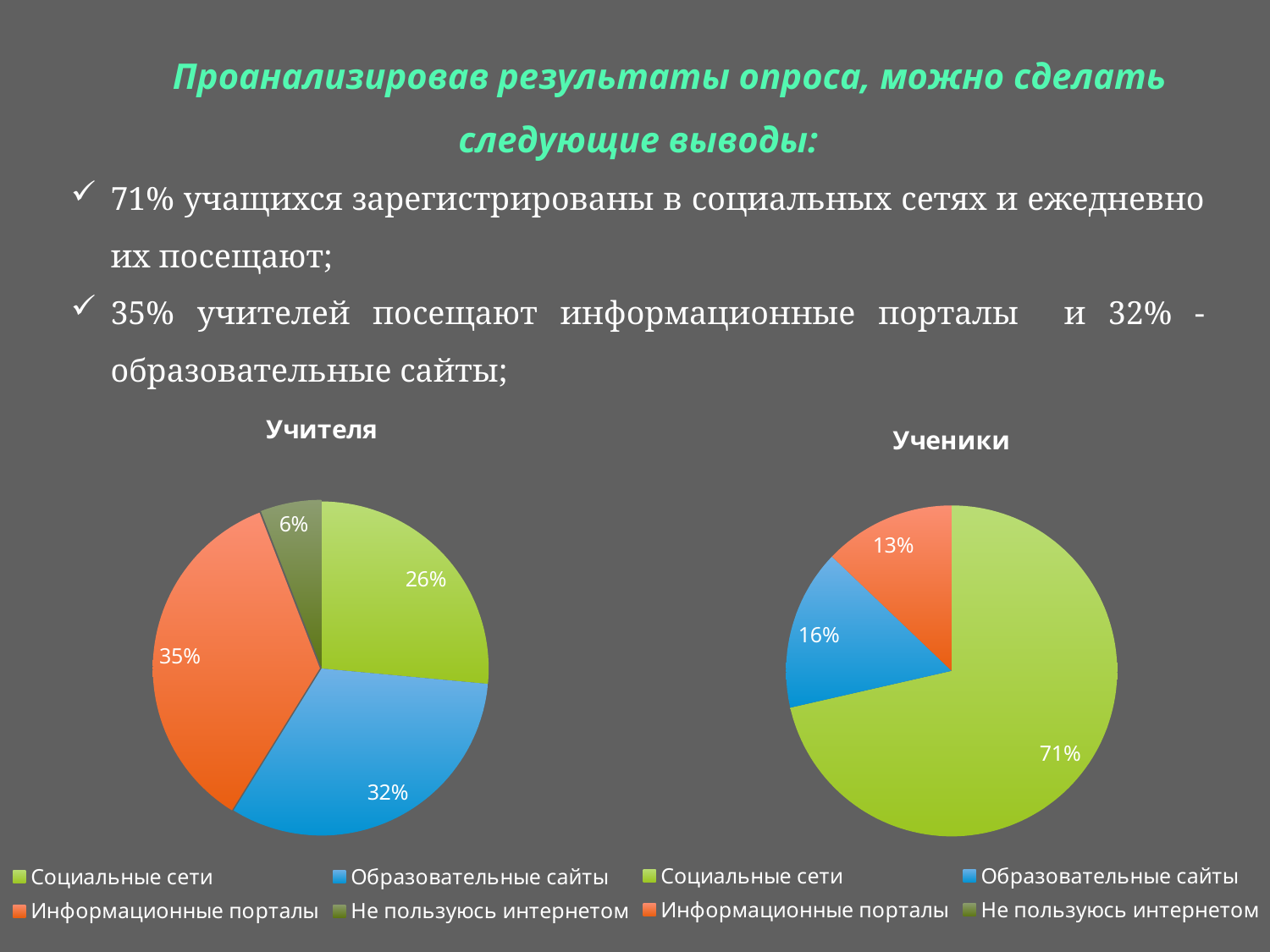
In the 'Учителя' chart, what percentage is shown for Образовательные сайты? 32% In the 'Учителя' chart, which category has the smallest slice? Не пользуюсь интернетом How many entries does the legend of the 'Учителя' chart list? 4 In the 'Учителя' chart, what percentage is shown for Информационные порталы? 35% In the 'Учителя' chart, what is the difference between the Информационные порталы and Социальные сети slices? 9% In the 'Ученики' chart, what percentage is shown for Образовательные сайты? 16% In the 'Ученики' chart, which category has the smallest labelled slice? Информационные порталы What type of chart is used for 'Ученики'? Pie chart In the 'Ученики' chart, what is the difference between the Социальные сети and Образовательные сайты slices? 55% In the 'Учителя' chart, which category has the largest slice? Информационные порталы In the 'Ученики' chart, what percentage is shown for Социальные сети? 71% Which is larger in the 'Учителя' chart: Образовательные сайты or Социальные сети? Образовательные сайты